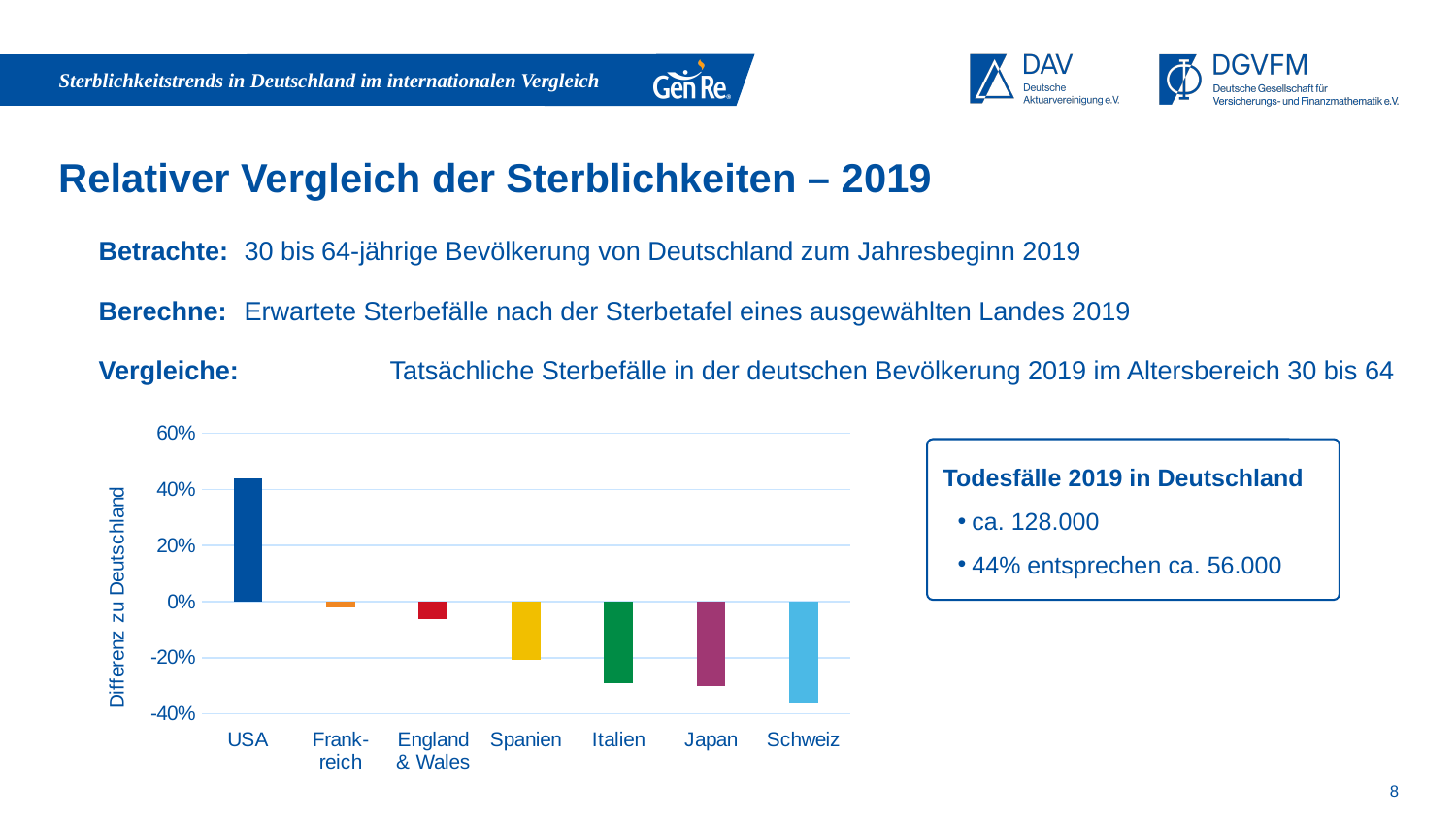
How many countries are shown on the x axis of the chart? 7 Which has the larger value, Spanien or Schweiz? Spanien Which country has the lowest value in the chart? Schweiz Is the value for Schweiz greater or less than -20%? less Which country has the highest value in the chart? USA What is the title of the chart's vertical axis? Differenz zu Deutschland Do the values rise or fall from left to right along the x axis? fall What kind of chart is shown on the slide? bar chart Is the value for Italien greater or less than -20%? less Is the value for Frankreich greater or less than -20%? greater Which has the larger value, USA or Japan? USA